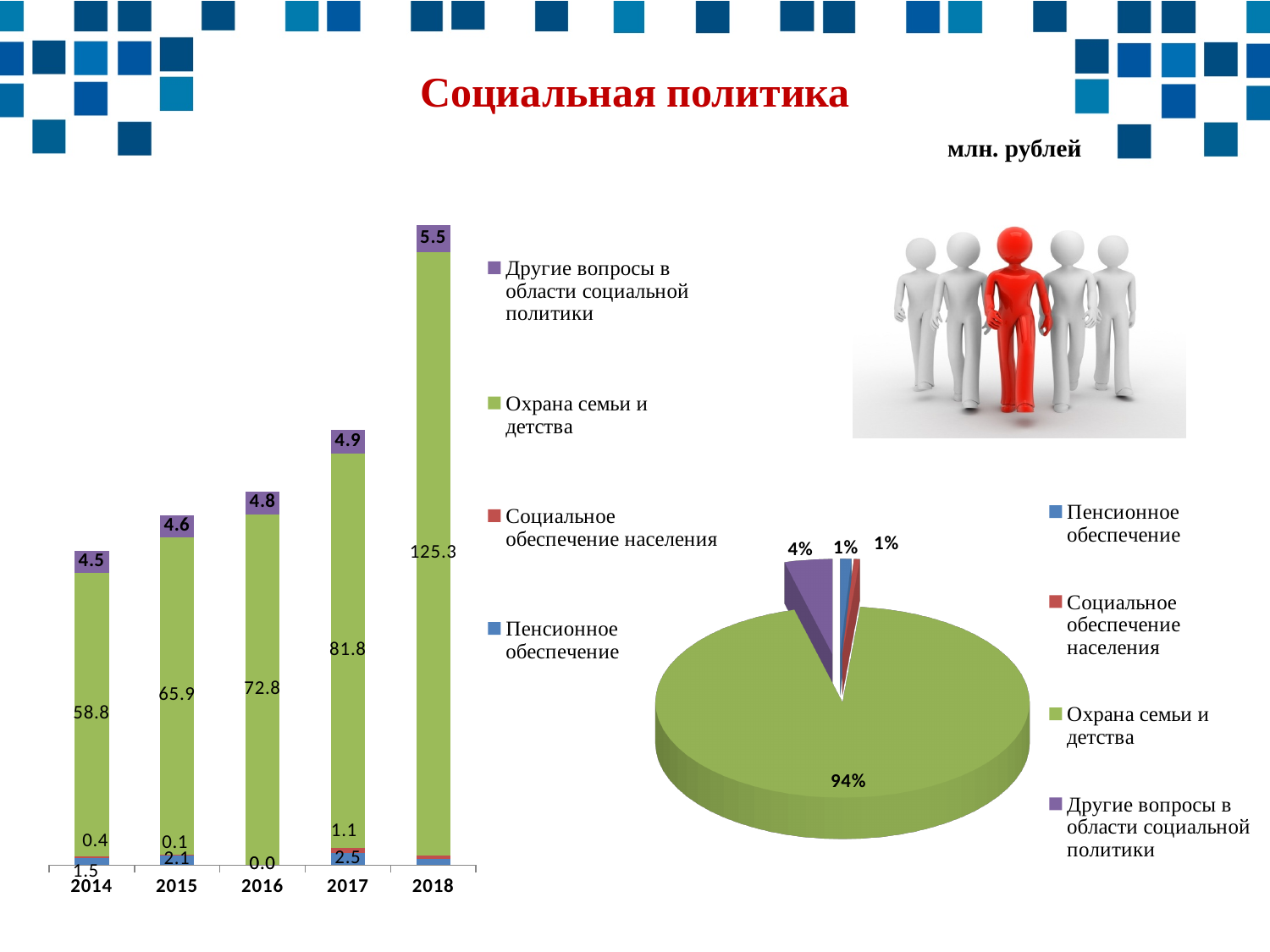
How many years are shown on the x axis of the stacked bar chart? 5 In the pie chart, what share does Охрана семьи и детства have? 94% In the stacked bar chart, what is the total of the 2017 bar? 90.3 In the stacked bar chart, what is the difference between the Охрана семьи и детства values for 2018 and 2017? 43.5 In the stacked bar chart, does the value for Охрана семьи и детства rise or fall from 2014 to 2018? rises In the stacked bar chart, which year has the highest value for Охрана семьи и детства? 2018 In the stacked bar chart, what is the value for Другие вопросы в области социальной политики in 2016? 4.8 In the stacked bar chart, what is the value for Охрана семьи и детства in 2018? 125.3 In the stacked bar chart, which is larger: Другие вопросы в области социальной политики in 2015 or in 2014? 2015 In the pie chart, what share does Другие вопросы в области социальной политики have? 4% How many series does the legend of the stacked bar chart list? 4 In the stacked bar chart, what is the value for Социальное обеспечение населения in 2017? 1.1